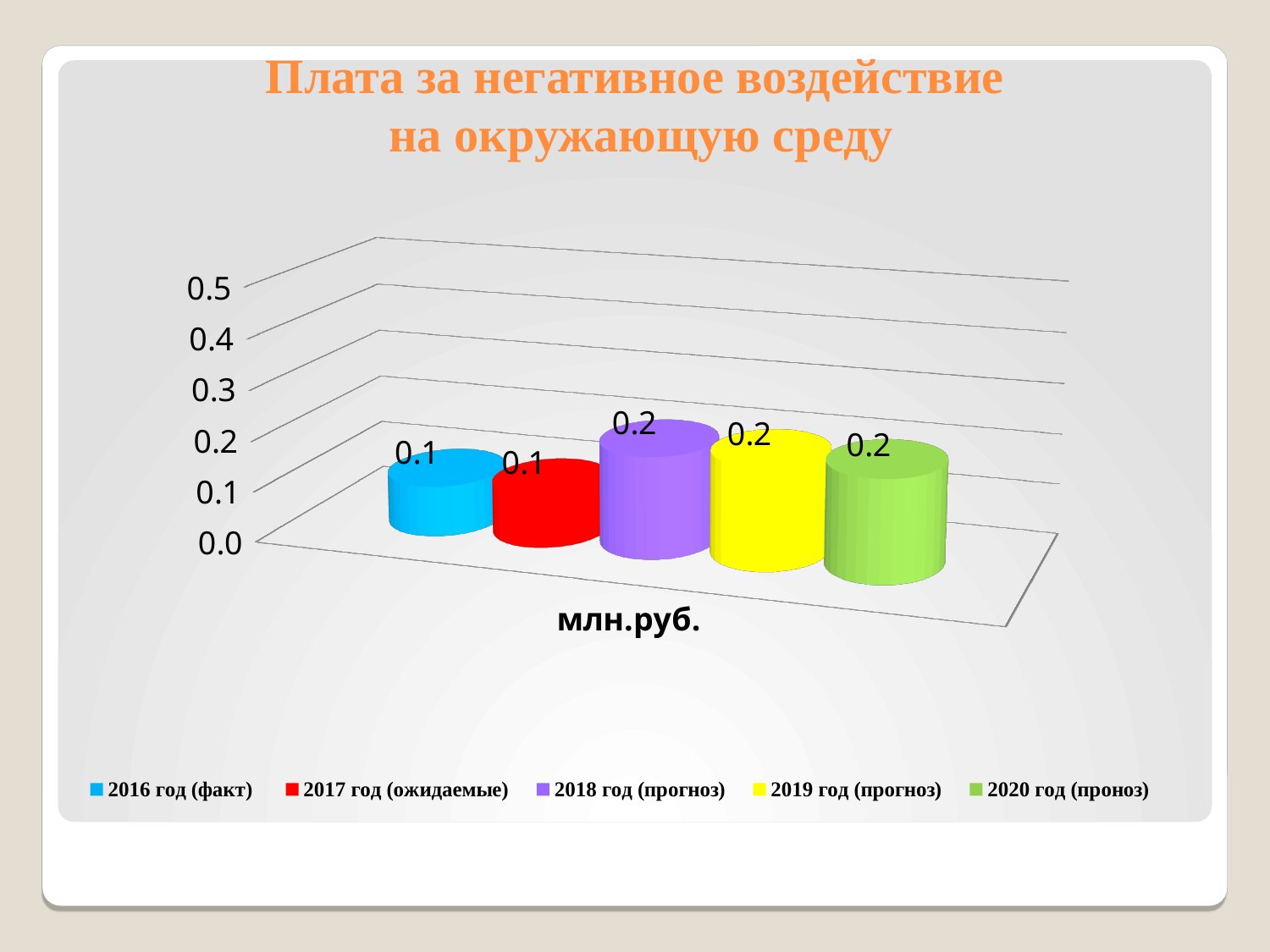
Do the values rise or fall from 2016 to 2020? rise What kind of chart is shown on the slide? bar chart What is the difference between the value for 2018 год (прогноз) and the value for 2017 год (ожидаемые)? 0.1 What is the value for 2017 год (ожидаемые)? 0.1 How many bars are plotted on the chart? 5 Is the value for 2020 год (проноз) greater or less than 0.3? less What is the value for 2016 год (факт)? 0.1 What is the title of the chart? Плата за негативное воздействие на окружающую среду Which is larger, the value for 2016 год (факт) or the value for 2019 год (прогноз)? 2019 год (прогноз) How many series does the legend list? 5 What is the value for 2018 год (прогноз)? 0.2 What is the value for 2020 год (проноз)? 0.2